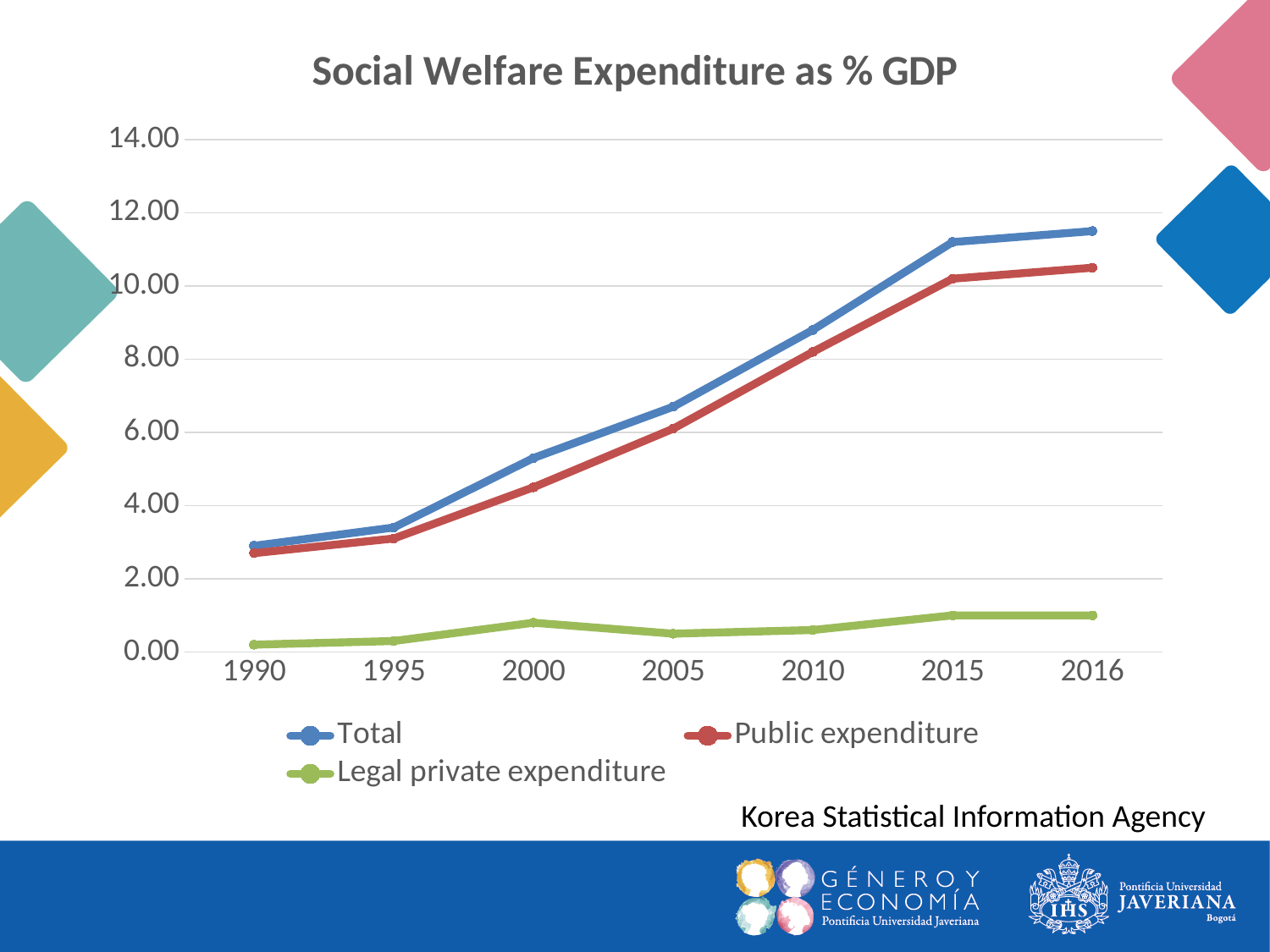
In which year is the Total series at its highest? 2016 In which year is the Legal private expenditure series at its lowest? 1990 How many years are plotted along the x axis? 7 What is the title of the chart? Social Welfare Expenditure as % GDP How many series does the legend list? 3 Which source is credited below the chart? Korea Statistical Information Agency Is the value for Legal private expenditure in 2016 greater or less than 2.00? less In 2010, which is larger: Total or Public expenditure? Total Is the value for Total in 2016 greater or less than 10.00? greater What kind of chart is shown on the slide? line chart Is the value for Public expenditure in 2005 greater or less than 8.00? less Does the Total series rise or fall from 1990 to 2016? rise